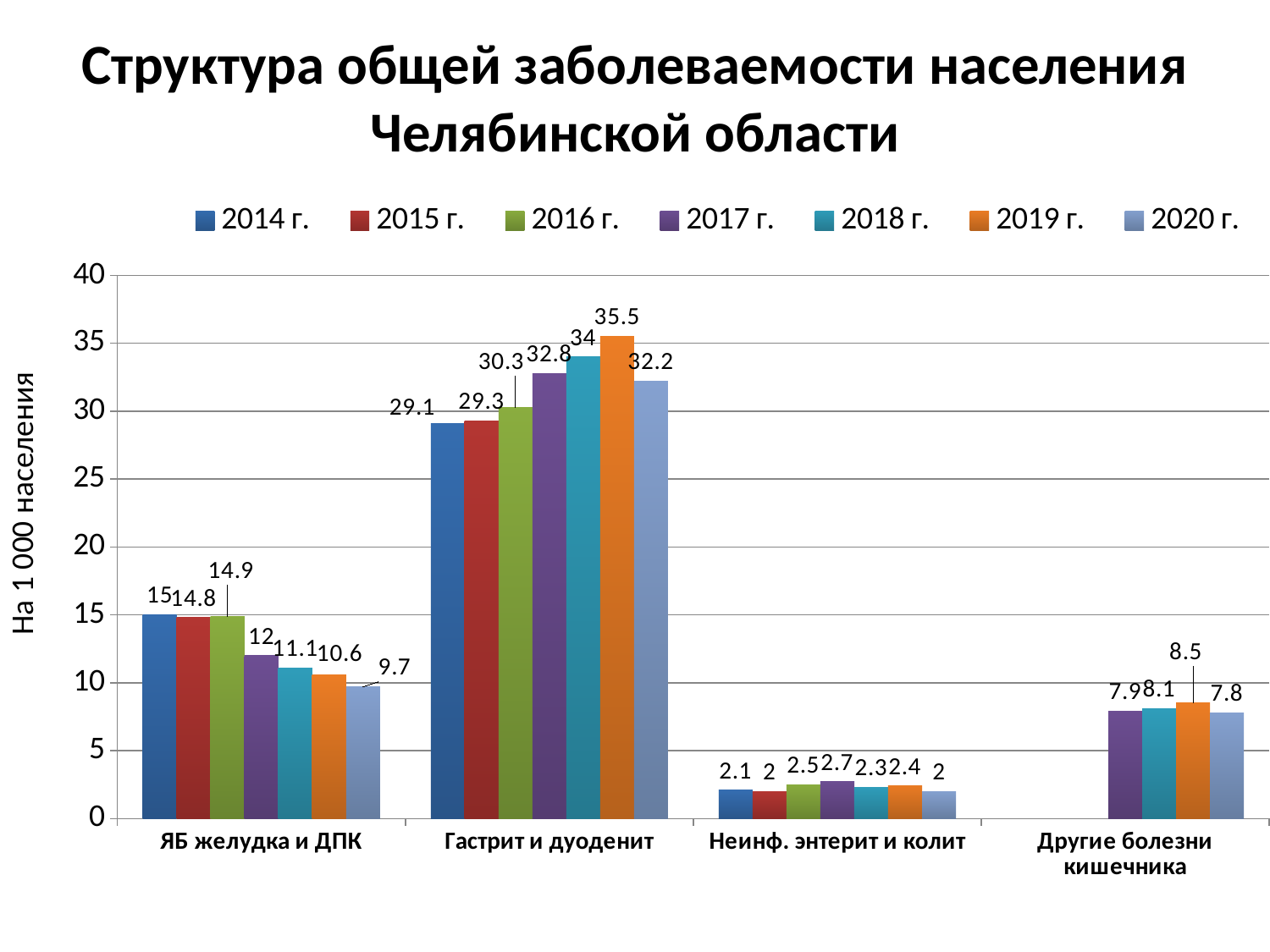
Which year has the lowest value in the category ЯБ желудка и ДПК? 2020 г. What is the value for 2014 г. in the category ЯБ желудка и ДПК? 15 Which is larger in the category Неинф. энтерит и колит: the value for 2017 г. or the value for 2018 г.? 2017 г. What is the label of the vertical axis? На 1 000 населения What is the value for 2020 г. in the category Другие болезни кишечника? 7.8 How many categories are shown on the x axis? 4 How many series does the legend list? 7 Do the values for ЯБ желудка и ДПК rise or fall from 2017 г. to 2020 г.? fall What is the value for 2019 г. in the category Гастрит и дуоденит? 35.5 What is the difference between the 2014 г. and 2020 г. values in the category ЯБ желудка и ДПК? 5.3 What type of chart is shown on the slide? bar chart Which year has the highest value in the category Гастрит и дуоденит? 2019 г.